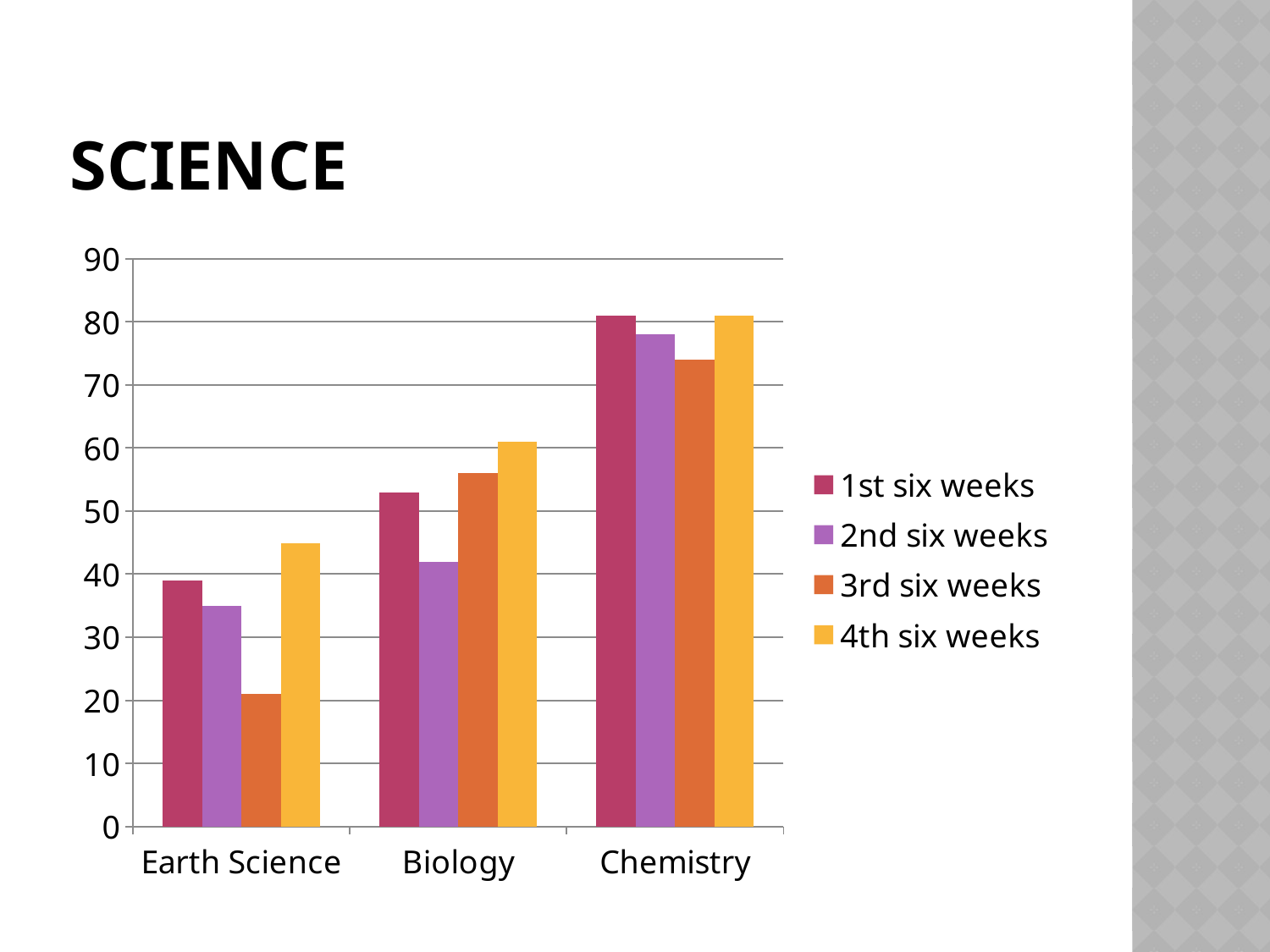
How many series does the legend list? 4 What is the title of the slide containing the chart? SCIENCE What kind of chart is shown on the slide? bar chart For Biology, which six-weeks period has the highest value? 4th six weeks Which is larger for Biology: the 1st six weeks value or the 2nd six weeks value? 1st six weeks Which subject has the highest values overall? Chemistry For Earth Science, which six-weeks period has the lowest value? 3rd six weeks Is the value for Biology in the 2nd six weeks greater or less than 50? less For Earth Science, which six-weeks period has the highest value? 4th six weeks Is the value for Chemistry in the 3rd six weeks greater or less than 70? greater Is the value for Earth Science in the 3rd six weeks greater or less than 30? less How many subject categories are shown on the x axis? 3